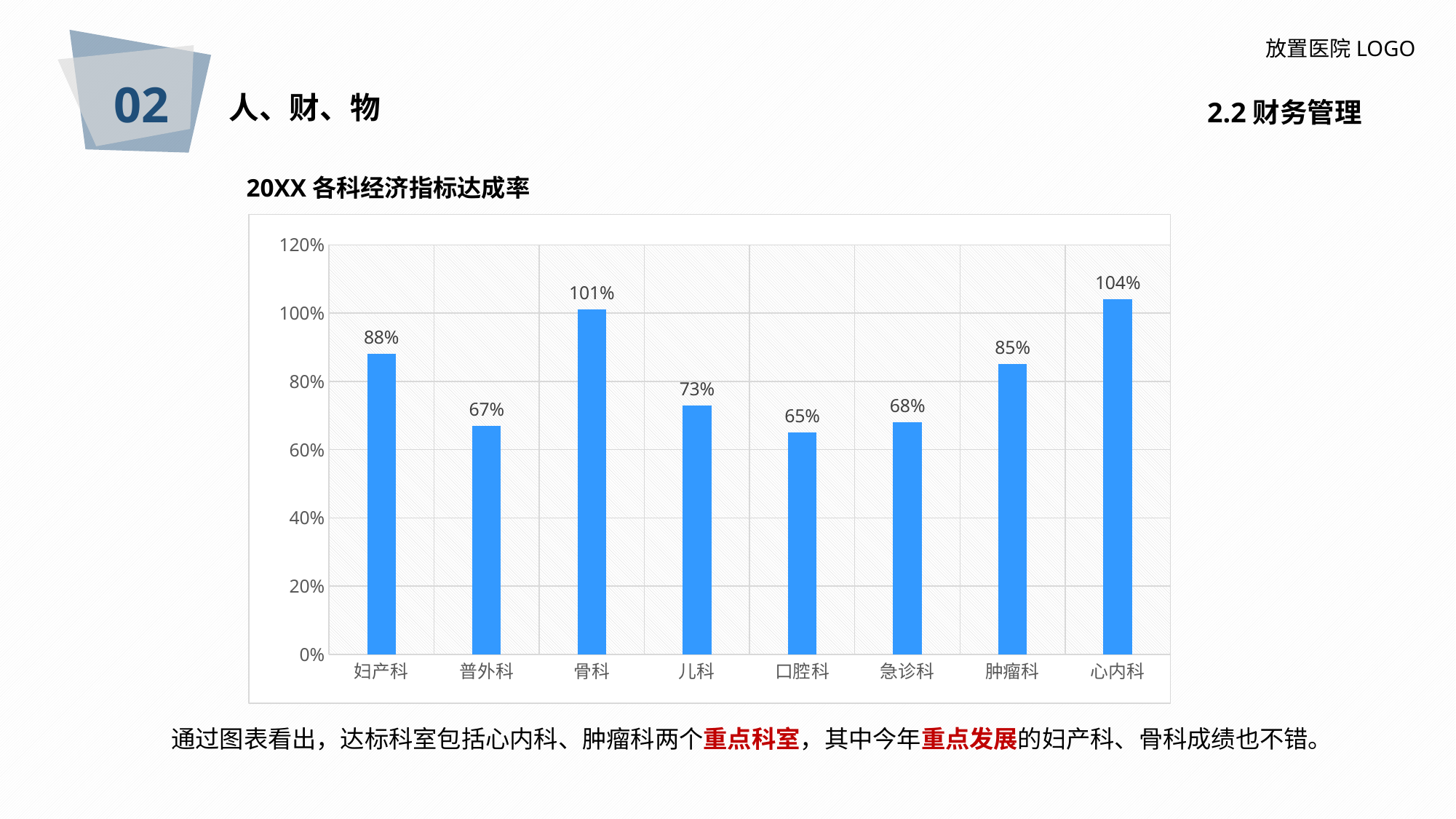
What is the value for 肿瘤科? 85% What is the value for 口腔科? 65% What is the title of the chart? 20XX 各科经济指标达成率 Which is larger, the value for 儿科 or the value for 急诊科? 儿科 What is the difference between the values for 心内科 and 骨科? 3% Which department has the highest value? 心内科 How many departments are shown on the x axis? 8 Is the value for 肿瘤科 greater or less than 80%? greater What is the value for 骨科? 101% What is the difference between the values for 妇产科 and 普外科? 21% Which department has the lowest value? 口腔科 What kind of chart is shown? bar chart